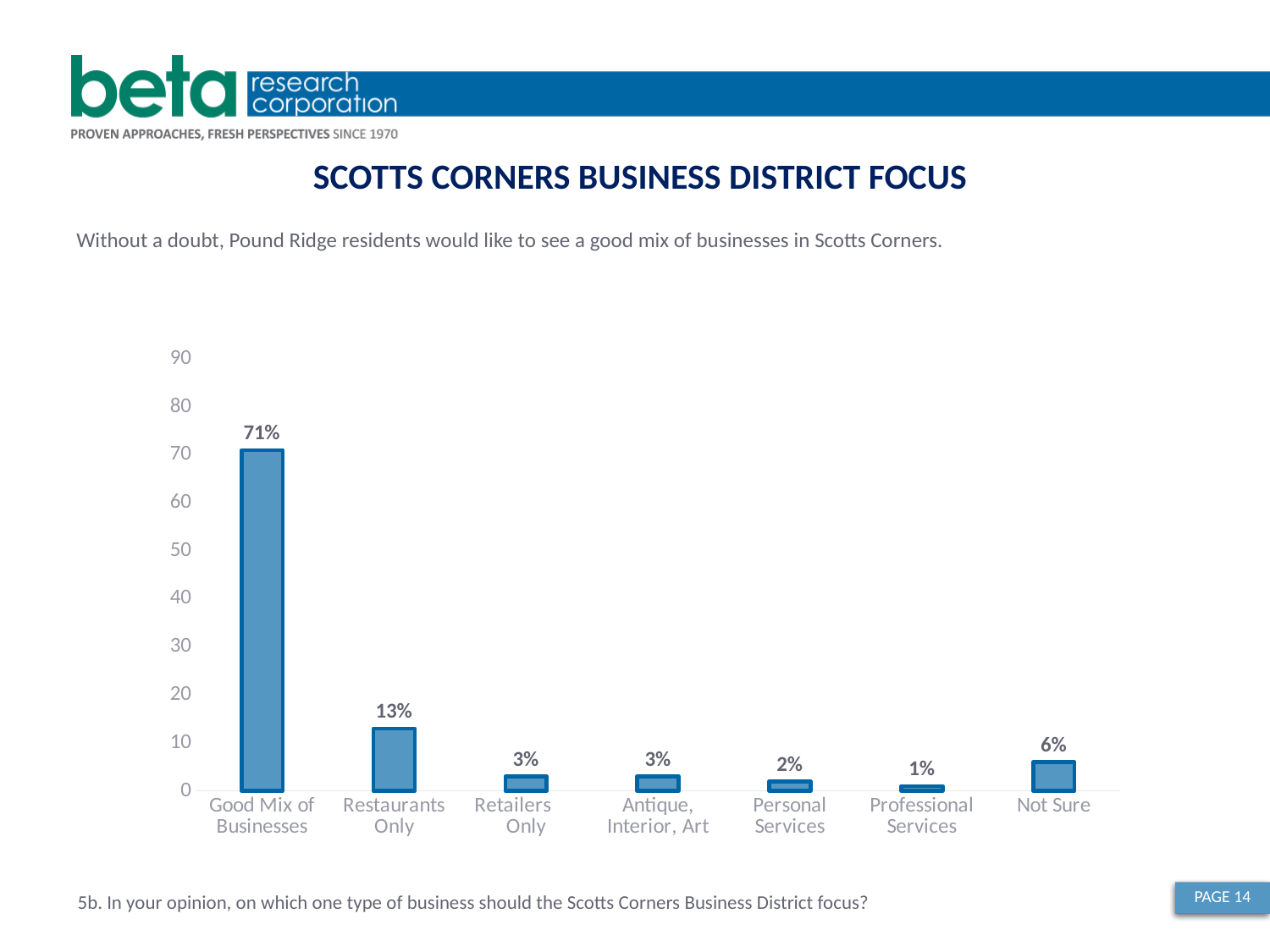
What percentage is shown for Not Sure? 6% What percentage of respondents chose Good Mix of Businesses? 71% Which category has the highest value? Good Mix of Businesses Is the value for Restaurants Only greater or less than 20? less What is the value for Professional Services? 1% Which is larger, the value for Not Sure or the value for Personal Services? Not Sure What kind of chart is shown on the slide? Bar chart What is the difference between Good Mix of Businesses and Restaurants Only? 58% What is the title of the slide containing the chart? SCOTTS CORNERS BUSINESS DISTRICT FOCUS Which category has the lowest value? Professional Services How many categories are shown on the x axis? 7 What is the value shown for Restaurants Only? 13%